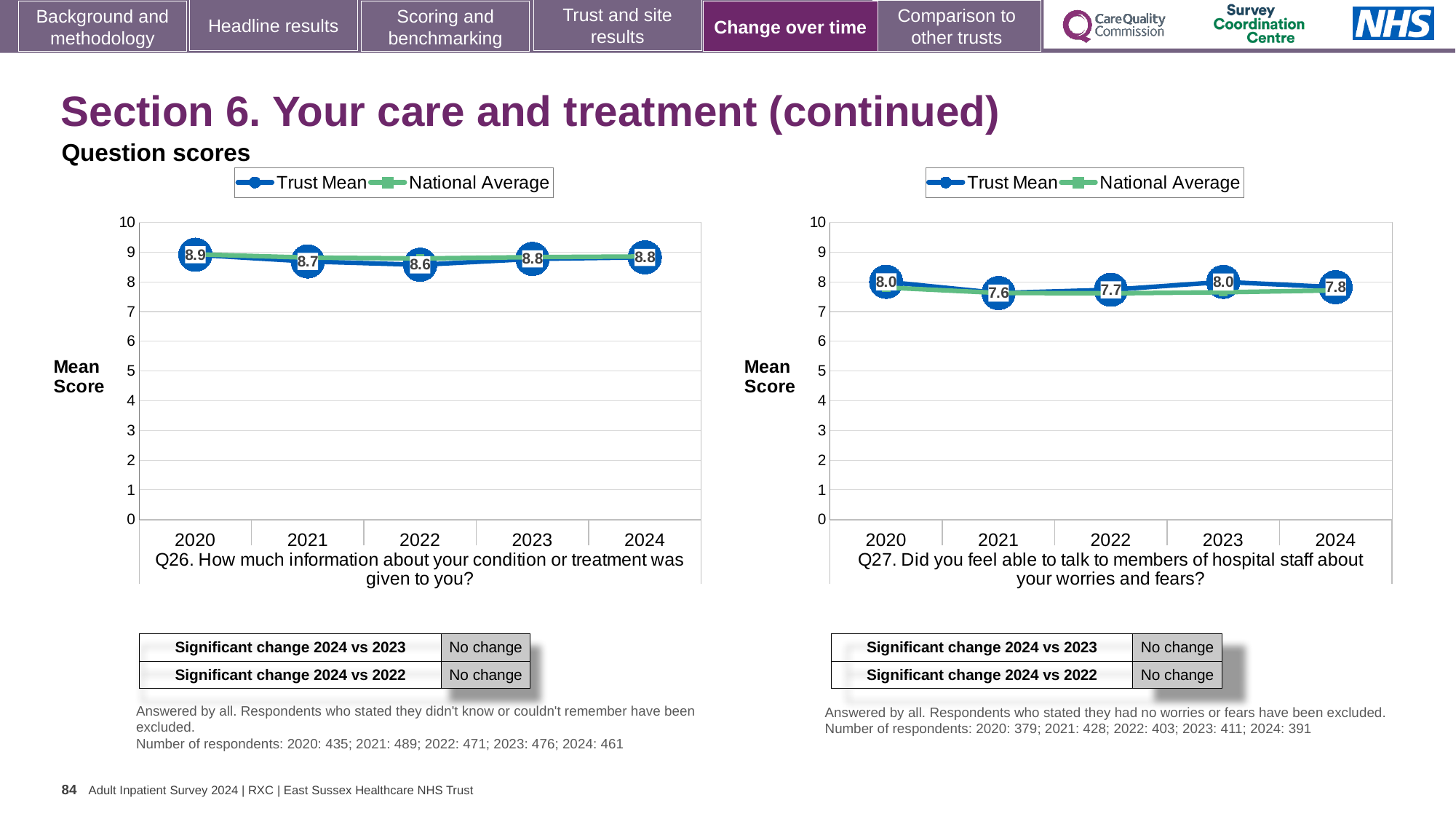
In the Q26 chart on the left, what is the Trust Mean score for 2020? 8.9 In the Q27 chart on the right, what is the difference between the Trust Mean scores for 2020 and 2021? 0.4 In the Q26 chart on the left, which year has the larger Trust Mean score, 2020 or 2021? 2020 In the Q27 chart on the right, which year has the lowest Trust Mean score? 2021 In the Q26 chart on the left, which year has the lowest Trust Mean score? 2022 In the Q27 chart on the right, is the National Average value for 2024 greater or less than 7? greater What kind of chart is the Q27 chart on the right? Line chart How many years are plotted on the x axis of the Q27 chart on the right? 5 How many series does the legend of the Q26 chart on the left list? 2 In the Q27 chart on the right, what is the Trust Mean score for 2021? 7.6 In the Q26 chart on the left, what is the difference between the Trust Mean scores for 2020 and 2022? 0.3 In the Q26 chart on the left, which year has the highest Trust Mean score? 2020